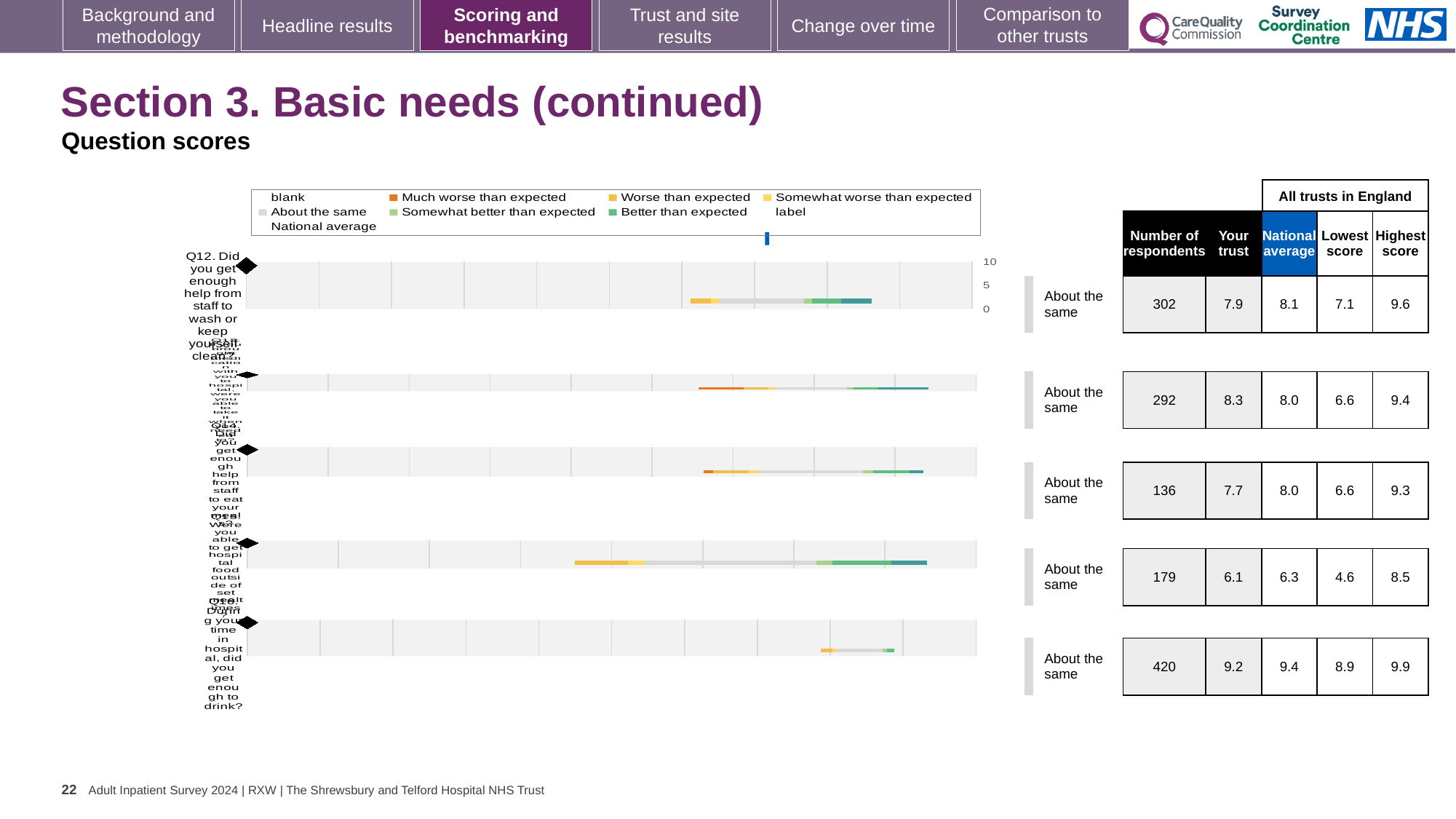
For the second row (Q13), which is larger: the 'Your trust' score or the national average? Your trust (8.3) How many questions (rows) are plotted on the chart? 5 What benchmark category is shown for every question on the slide? About the same For Q12 (the first row), what is the difference between the national average and the 'Your trust' score? 0.2 What is the highest score among all trusts in England for the bottom row (Q16)? 9.9 How many respondents are shown for Q12 (the first row of the chart)? 302 What is the national average for Q12 (the first row)? 8.1 What kind of chart is shown on the slide? Bar chart What is the 'Your trust' score for Q12 (the first row)? 7.9 Which row has the highest 'Your trust' score? The bottom row (Q16), 9.2 Which row has the lowest 'Your trust' score? The fourth row (Q15), 6.1 For the bottom row (Q16), what is the difference between the highest score and the lowest score? 1.0